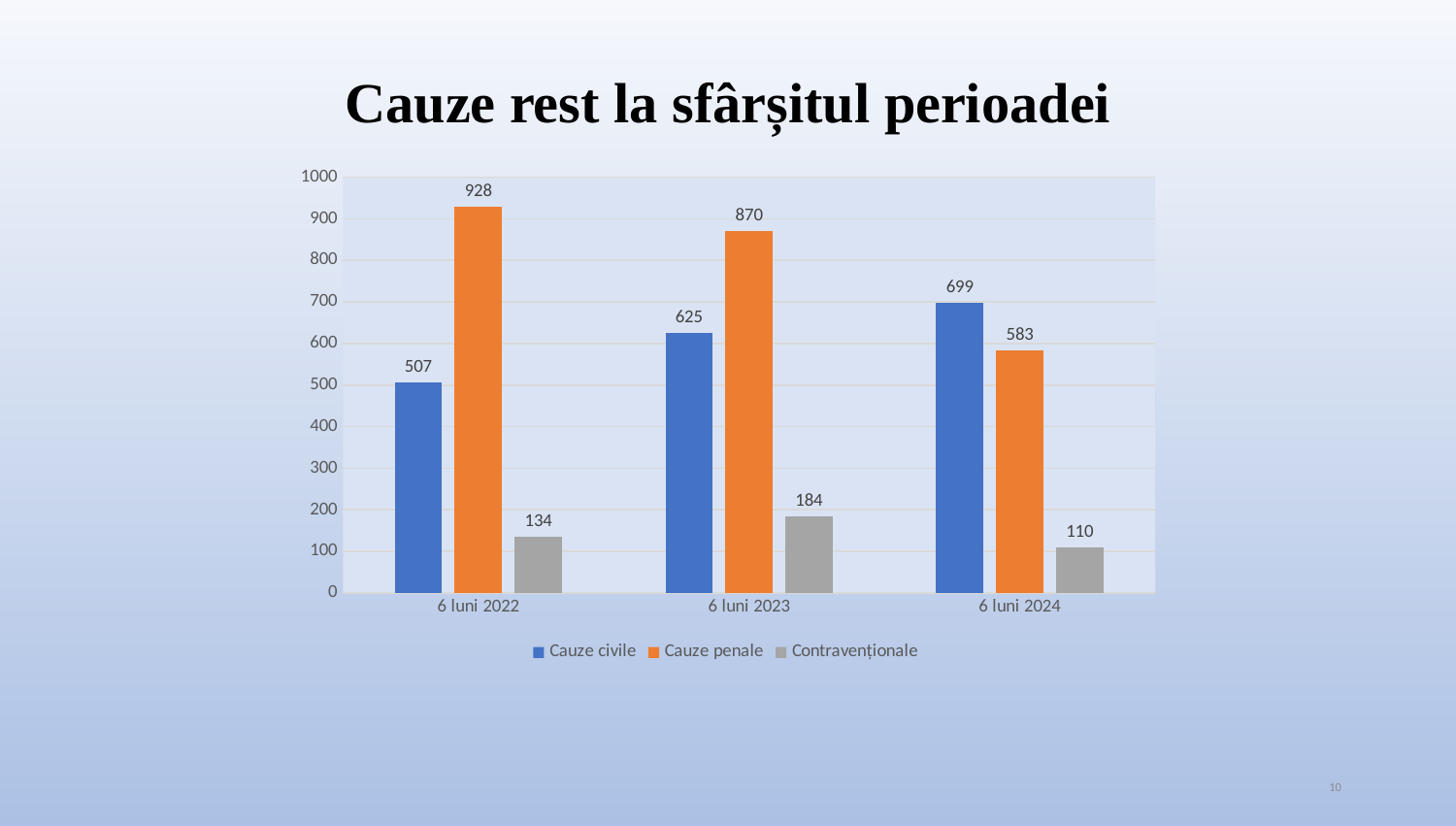
What is the title of the chart? Cauze rest la sfârșitul perioadei What is the value for Cauze penale in 6 luni 2022? 928 In which period is the value for Cauze civile the highest? 6 luni 2024 What is the difference between Cauze penale and Cauze civile in 6 luni 2023? 245 What is the value for Contravenționale in 6 luni 2023? 184 What kind of chart is shown on the slide? bar chart How many series does the legend list? 3 Which is larger in 6 luni 2024: Cauze civile or Cauze penale? Cauze civile Do the values for Cauze penale rise or fall from 6 luni 2022 to 6 luni 2024? fall How many periods are shown on the x axis? 3 In which period is the value for Cauze penale the lowest? 6 luni 2024 What is the value for Cauze civile in 6 luni 2024? 699